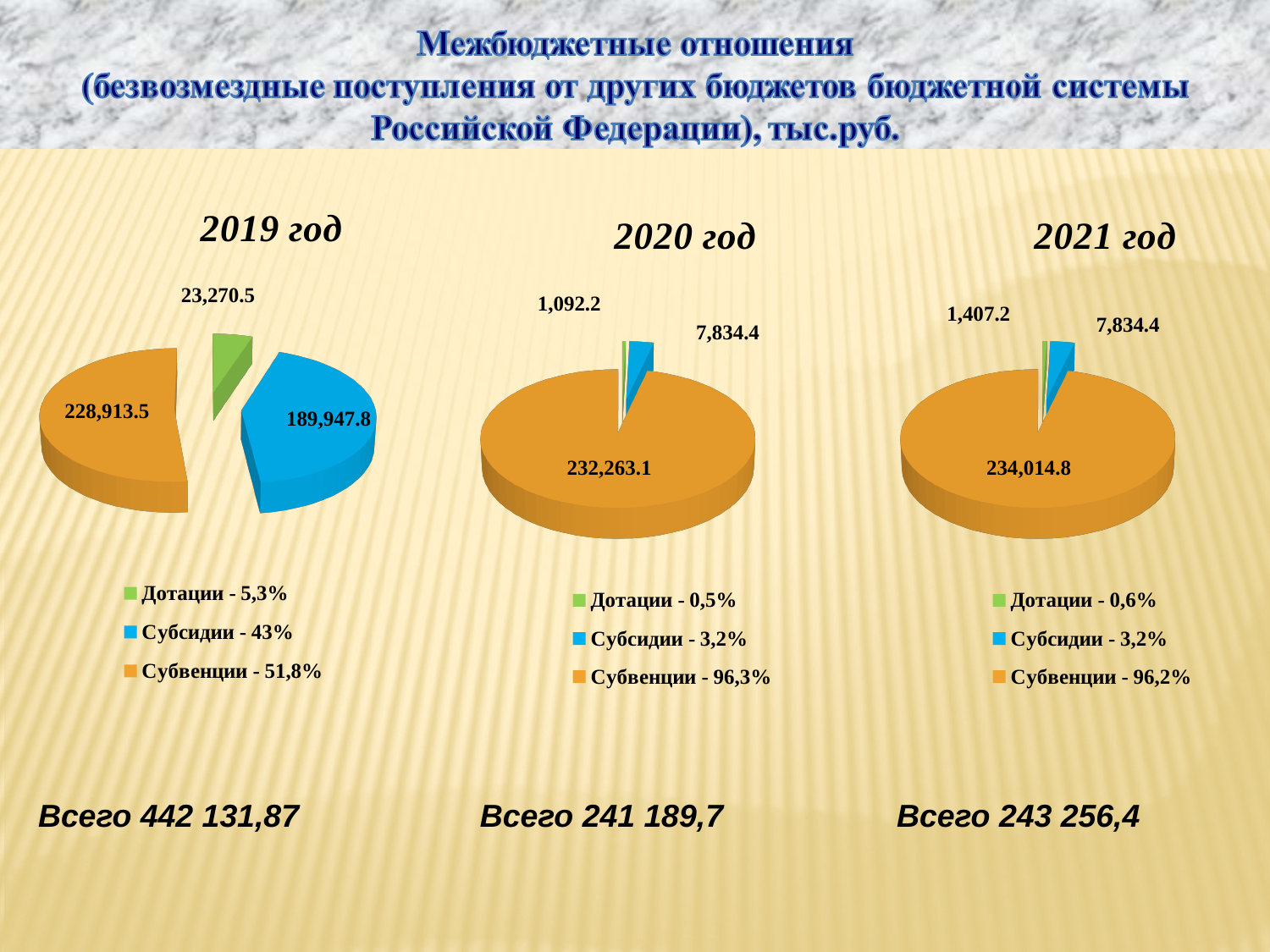
In the 2020 год pie chart, what is the value for Дотации? 1,092.2 According to the legend of the 2020 год chart, what share of the pie is Субвенции? 96,3% In the 2019 год pie chart, which category has the largest value? Субвенции In the 2019 год chart, what colour is the Субсидии slice? Blue What type of chart is used for 2021 год? Pie chart What is the difference between the Субвенции value in the 2021 год chart and the Субвенции value in the 2020 год chart? 1,751.7 In the 2019 год pie chart, what is the difference between the values for Субвенции and Субсидии? 38,965.7 In the 2019 год pie chart, which is larger: Дотации or Субсидии? Субсидии In the 2021 год pie chart, which category has the smallest value? Дотации In the 2021 год pie chart, what is the value for Субсидии? 7,834.4 How many slices does the 2020 год pie chart have? 3 In the 2019 год pie chart, what is the value for Субвенции? 228,913.5